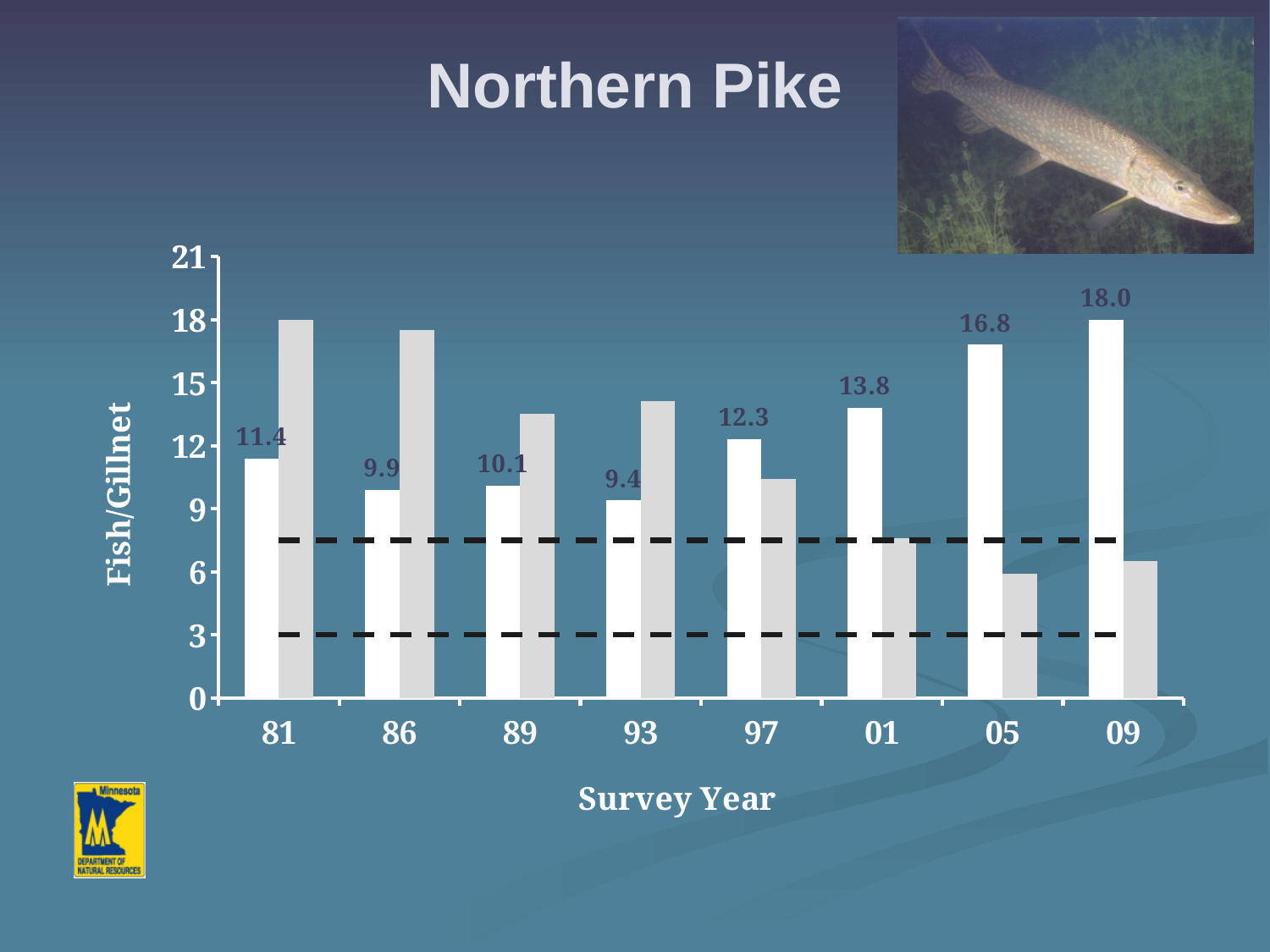
Is the value of the unlabeled gray bar for survey year 81 greater or less than 15? greater What is the labeled Fish/Gillnet value for survey year 81? 11.4 Do the labeled Fish/Gillnet values rise or fall from survey year 93 to survey year 09? rise What is the labeled Fish/Gillnet value for survey year 05? 16.8 Which labeled value is larger, survey year 86 or survey year 01? 01 Is the value of the unlabeled gray bar for survey year 05 greater or less than 9? less What kind of chart is shown on the slide? bar chart What is the difference between the labeled values for survey years 09 and 81? 6.6 What is the labeled Fish/Gillnet value for survey year 97? 12.3 How many survey years are shown on the x axis? 8 Which survey year has the lowest labeled Fish/Gillnet value? 93 Which survey year has the highest labeled Fish/Gillnet value? 09